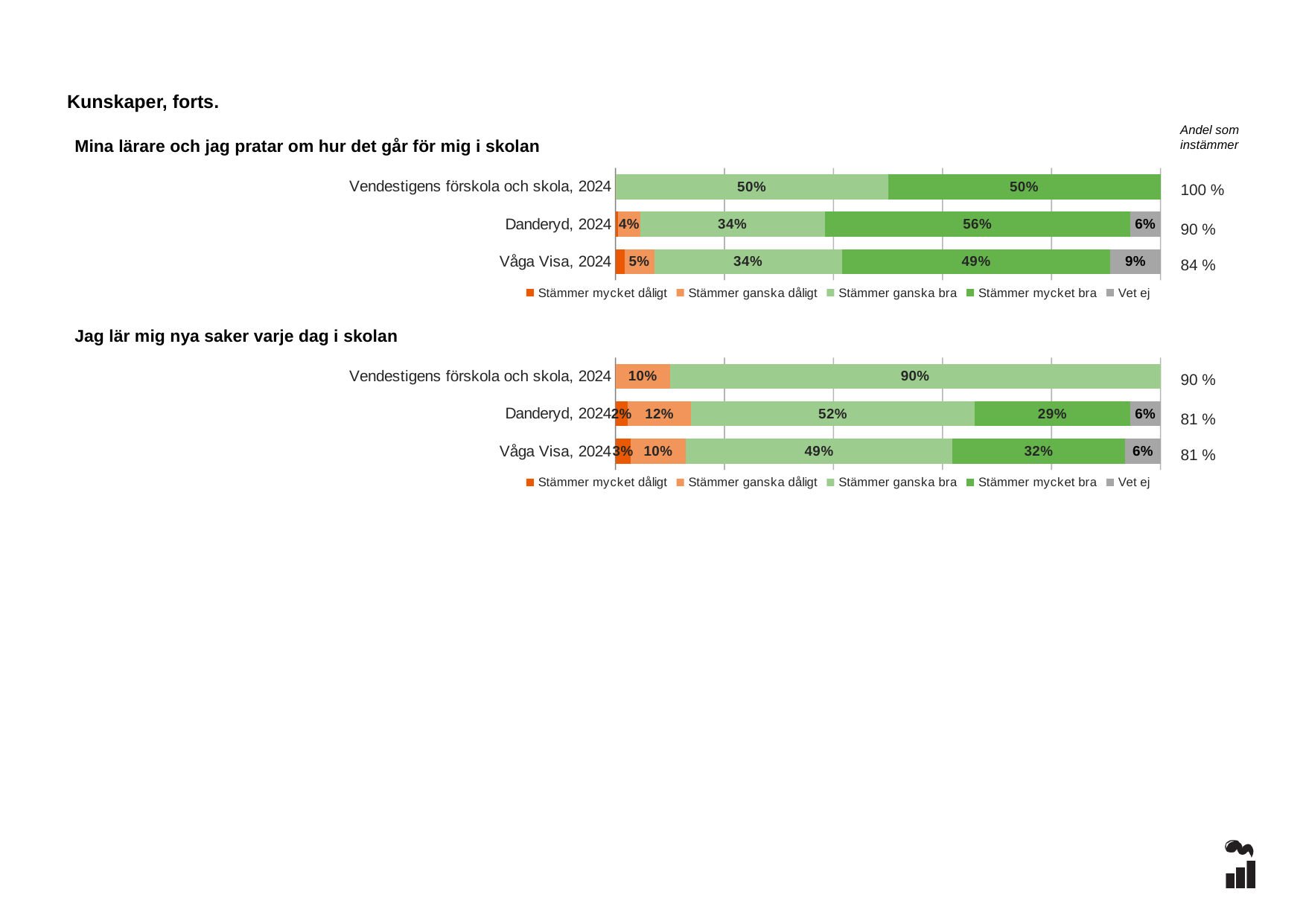
How many series does the legend of the chart 'Jag lär mig nya saker varje dag i skolan' list? 5 In the chart 'Mina lärare och jag pratar om hur det går för mig i skolan', what is the 'Vet ej' value for Våga Visa, 2024? 9% In the chart 'Jag lär mig nya saker varje dag i skolan', what is the 'Andel som instämmer' for Danderyd, 2024? 81 % In the chart 'Mina lärare och jag pratar om hur det går för mig i skolan', which category has the lowest 'Andel som instämmer'? Våga Visa, 2024 In the chart 'Jag lär mig nya saker varje dag i skolan', what is the 'Stämmer ganska bra' value for Vendestigens förskola och skola, 2024? 90% In the chart 'Jag lär mig nya saker varje dag i skolan', what is the 'Stämmer mycket bra' value for Våga Visa, 2024? 32% What kind of chart is 'Jag lär mig nya saker varje dag i skolan'? Stacked bar chart How many categories are shown in the chart 'Mina lärare och jag pratar om hur det går för mig i skolan'? 3 In the chart 'Jag lär mig nya saker varje dag i skolan', which is larger: the 'Stämmer ganska bra' value for Danderyd, 2024 or for Våga Visa, 2024? Danderyd, 2024 In the chart 'Mina lärare och jag pratar om hur det går för mig i skolan', what is the difference between the 'Stämmer mycket bra' values for Danderyd, 2024 and Våga Visa, 2024? 7% In the chart 'Mina lärare och jag pratar om hur det går för mig i skolan', what is the 'Andel som instämmer' for Vendestigens förskola och skola, 2024? 100 % In the chart 'Mina lärare och jag pratar om hur det går för mig i skolan', what is the 'Stämmer mycket bra' value for Danderyd, 2024? 56%